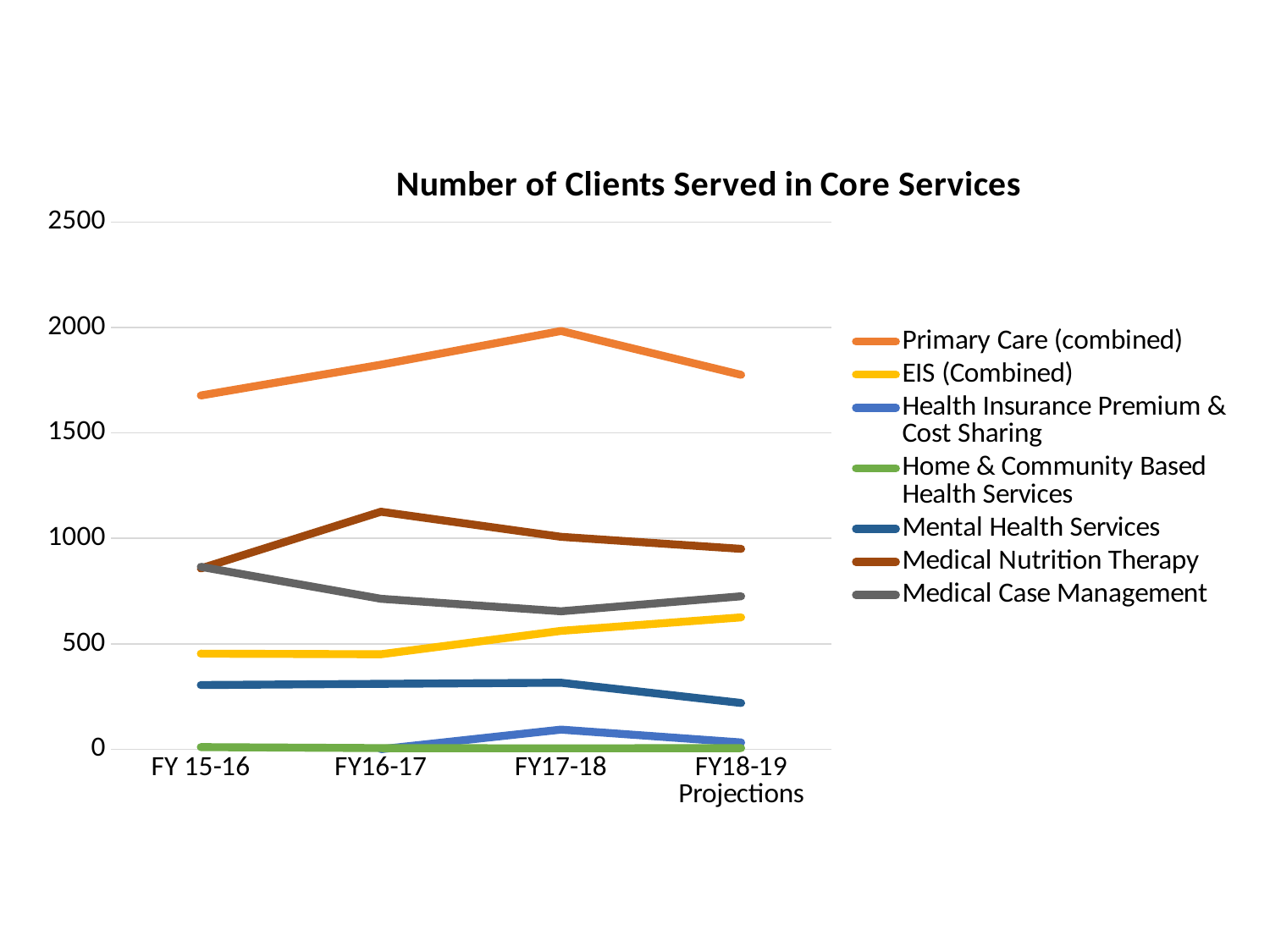
What kind of chart is shown on the slide? line chart Is the value for Primary Care (combined) in FY17-18 greater or less than 1500? greater Does the Medical Case Management line rise or fall from FY 15-16 to FY17-18? fall Is the value for EIS (Combined) in FY18-19 Projections greater or less than 500? greater In FY16-17, which is larger: Medical Nutrition Therapy or Medical Case Management? Medical Nutrition Therapy How many fiscal-year categories are shown on the x axis? 4 Which series has the lowest value in FY17-18? Home & Community Based Health Services How many series does the legend list? 7 Is the value for Medical Nutrition Therapy in FY16-17 greater or less than 1000? greater Which series has the highest value in FY17-18? Primary Care (combined) What is the title of the chart? Number of Clients Served in Core Services